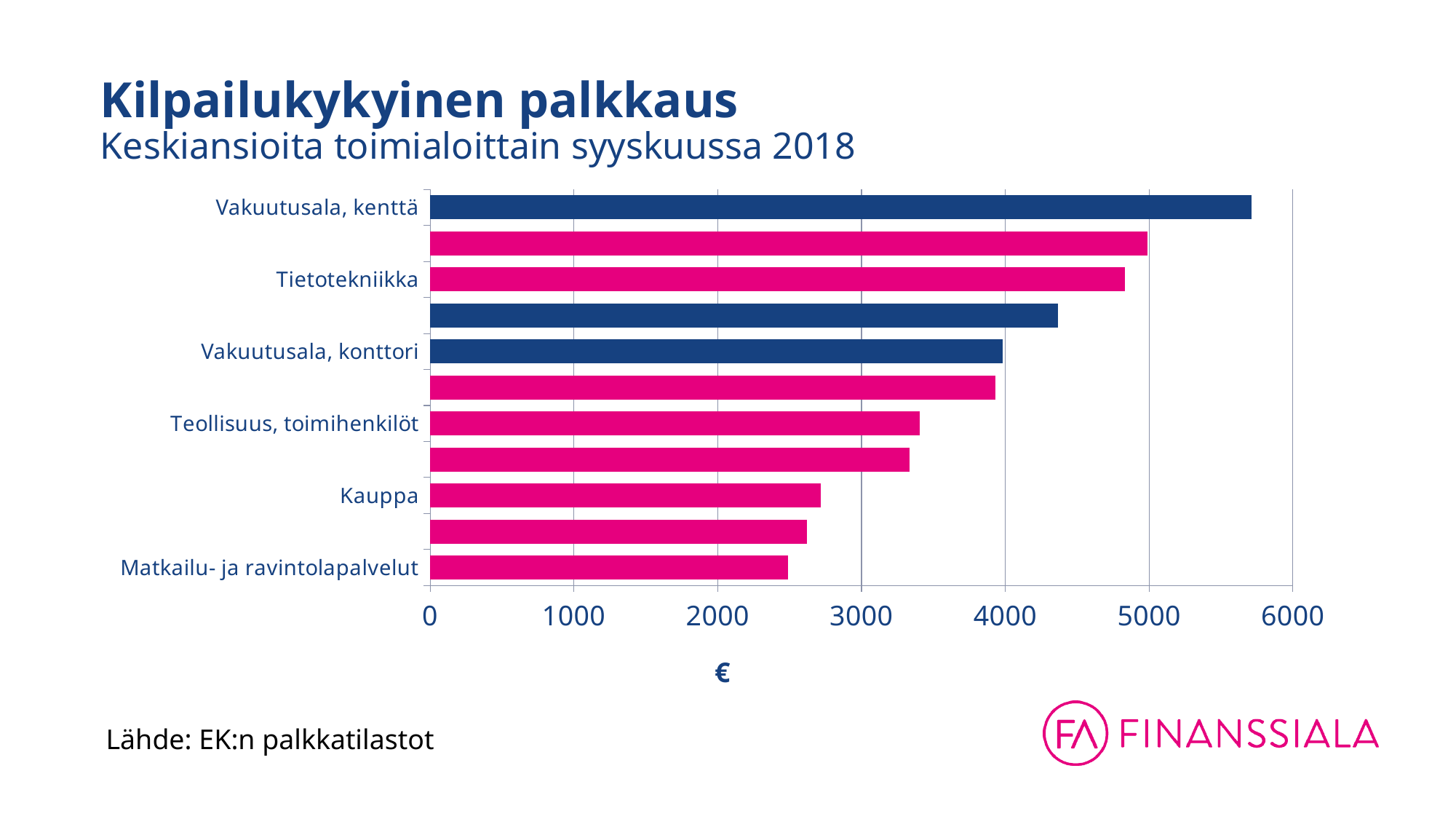
Is the value for Tietotekniikka greater or less than 5000? less Is the value for Vakuutusala, konttori greater or less than 3000? greater Which is larger, the value for Tietotekniikka or the value for Kauppa? Tietotekniikka Is the value for Vakuutusala, kenttä greater or less than 5000? greater Which labelled category has the highest average earnings in the chart? Vakuutusala, kenttä Which labelled category has the lowest average earnings in the chart? Matkailu- ja ravintolapalvelut What kind of chart is shown on the slide? bar chart How many bars are plotted in the chart? 11 What unit is shown on the horizontal axis of the chart? €